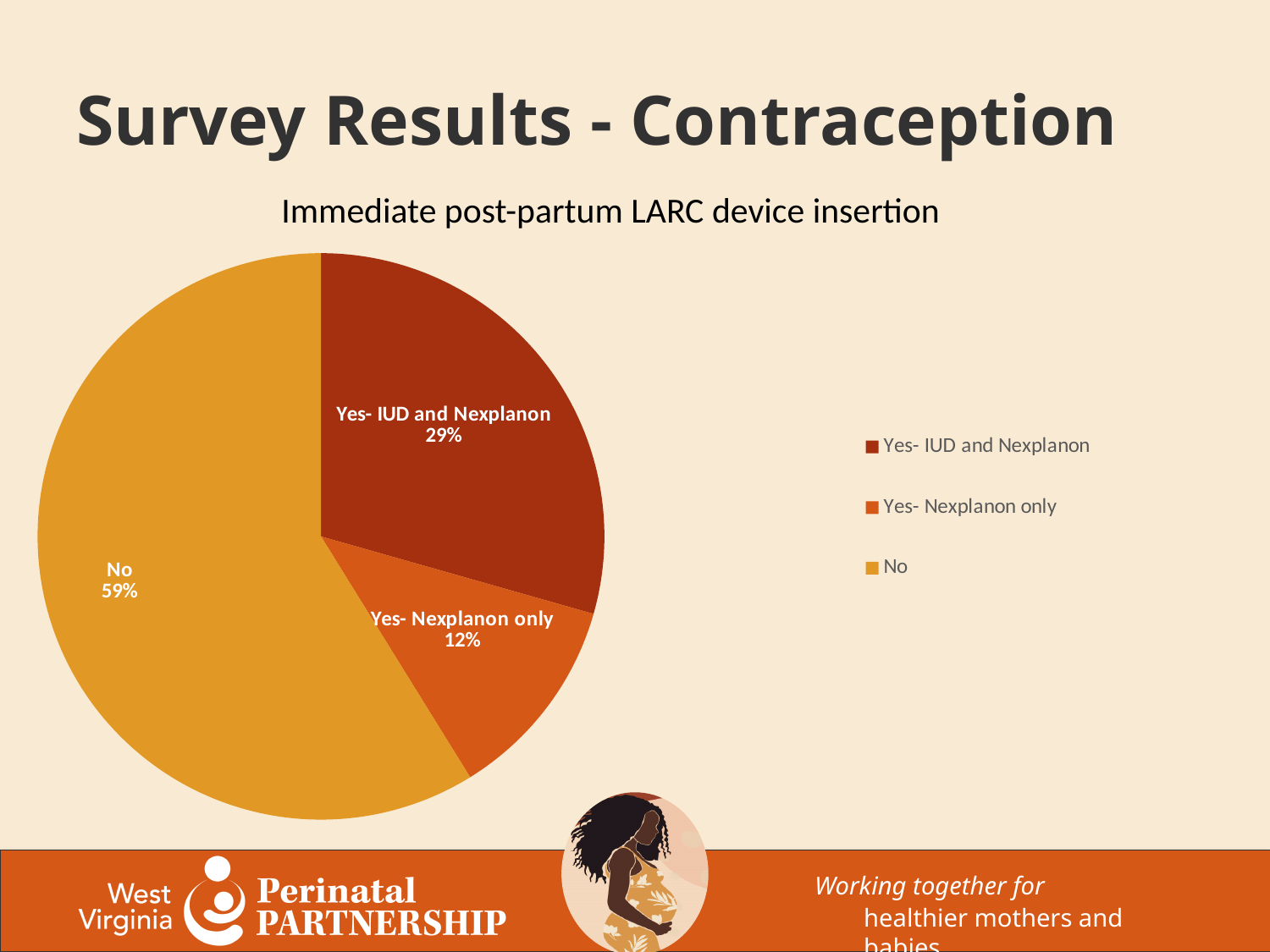
Which slice of the pie is the largest? No What is the difference in percentage points between the "No" slice and the "Yes- IUD and Nexplanon" slice? 30 What percentage of the pie is the "Yes- Nexplanon only" slice? 12% What colour is the "No" slice in the pie chart? yellow-orange Which is larger, the "Yes- IUD and Nexplanon" slice or the "Yes- Nexplanon only" slice? Yes- IUD and Nexplanon What percentage of the pie is the "No" slice? 59% How many slices does the pie chart have? 3 How many entries does the legend list? 3 What kind of chart is shown on the slide? pie chart What percentage of the pie is the "Yes- IUD and Nexplanon" slice? 29% What is the chart's title? Immediate post-partum LARC device insertion Which slice of the pie is the smallest? Yes- Nexplanon only